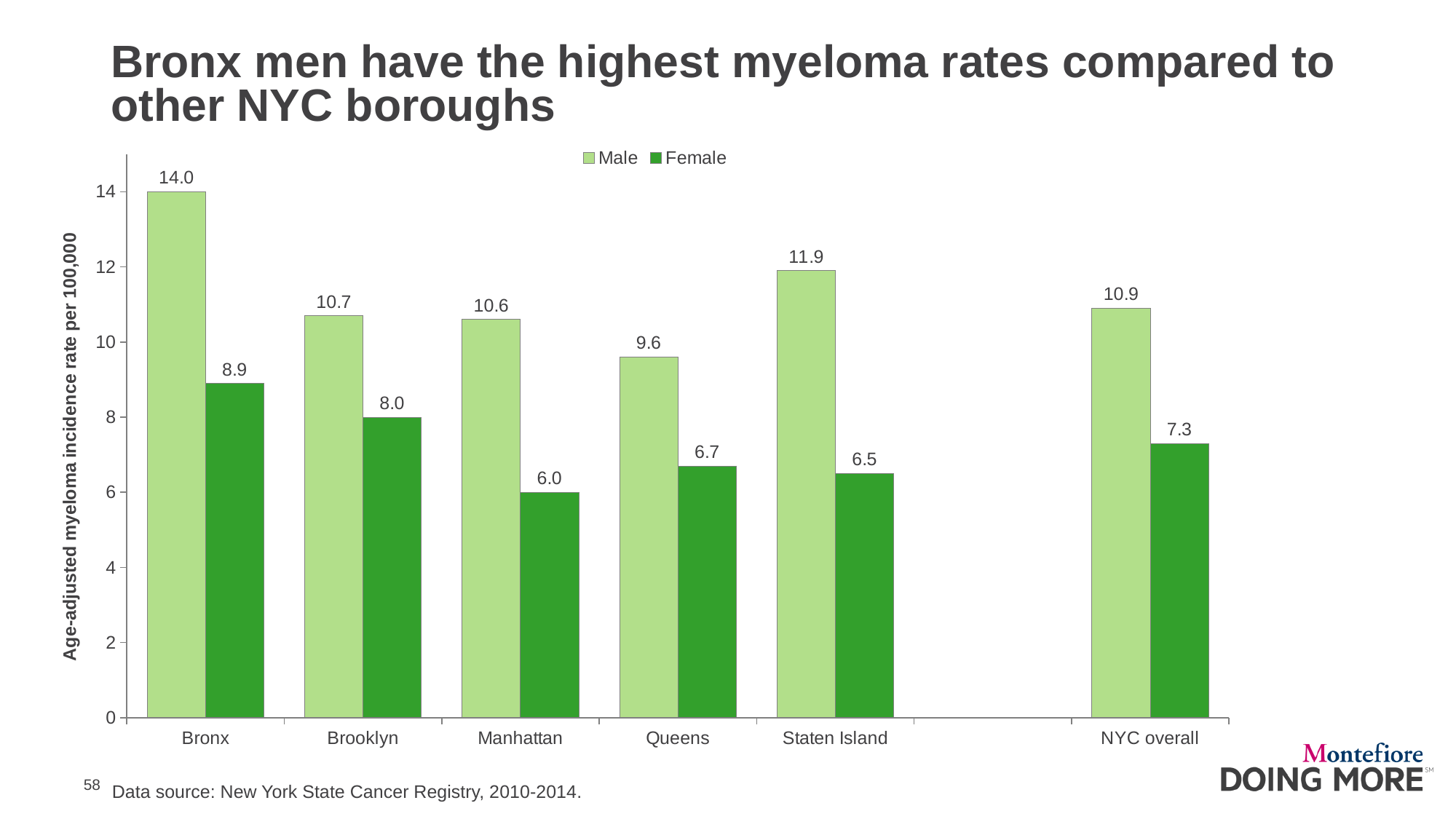
What is the difference between the Male and Female values for the Bronx? 5.1 What is the Female value for NYC overall? 7.3 What is the Male myeloma incidence rate for the Bronx? 14.0 Which category has the highest Male value? Bronx What is the label of the vertical axis? Age-adjusted myeloma incidence rate per 100,000 Which category has the lowest Female value? Manhattan Which is larger, the Male value for Brooklyn or the Male value for Staten Island? Staten Island What kind of chart is shown on the slide? bar chart What is the Female myeloma incidence rate for Manhattan? 6.0 How many series does the legend list? 2 Is the Female value for Queens greater or less than 8? less How many categories are shown on the x axis? 6